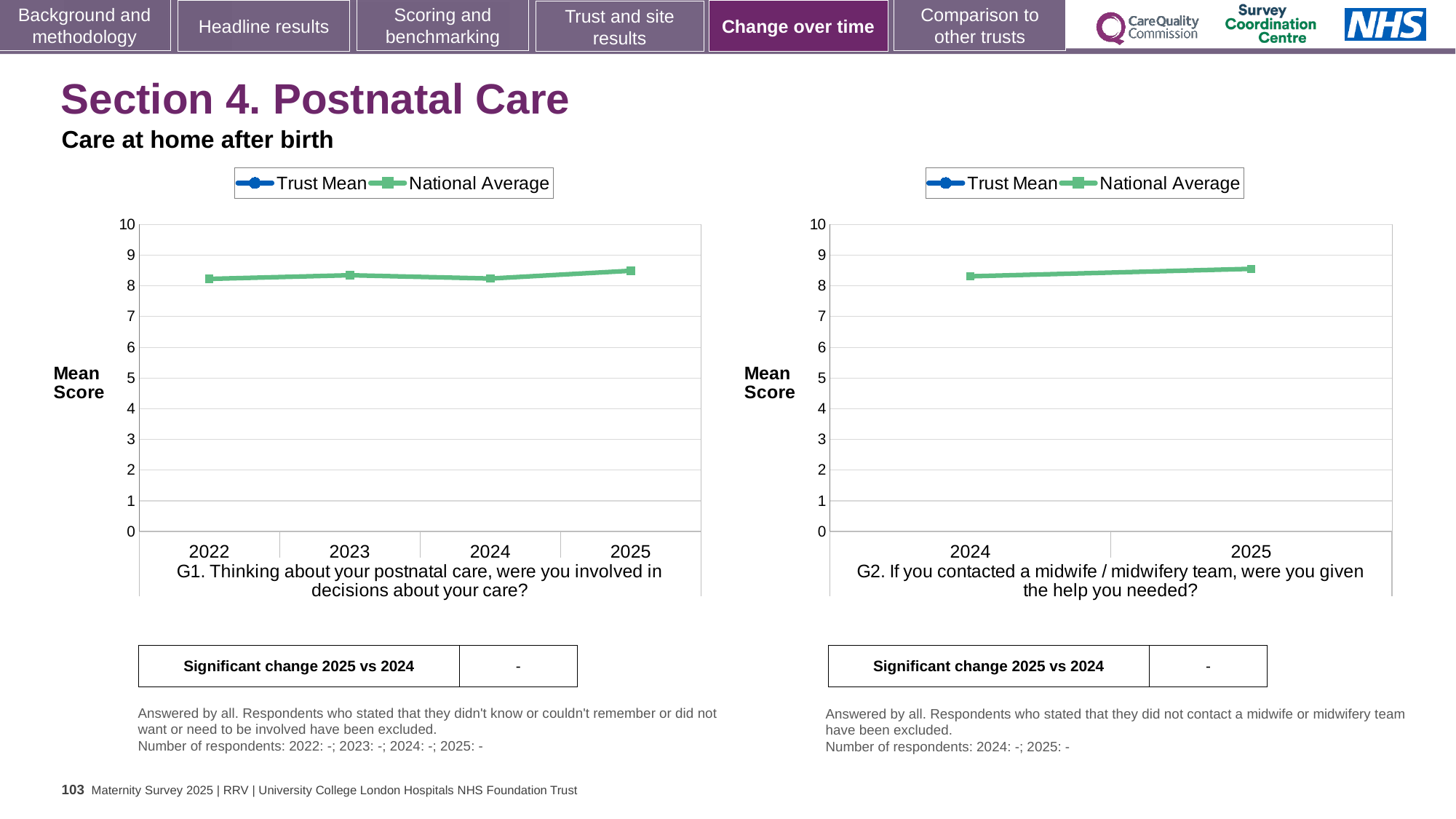
In the left chart (G1), is the National Average value for 2022 greater or less than 9? less What is the y-axis label on the left chart (G1)? Mean Score In the right chart (G2), which year has the higher National Average value, 2024 or 2025? 2025 What are the two legend entries on the right chart (G2)? Trust Mean, National Average How many series does the legend of the left chart (G1) list? 2 What kind of chart is the left chart (G1)? line chart In the left chart (G1), is the National Average value for 2025 greater or less than 8? greater How many years are shown on the x axis of the left chart (G1)? 4 How many years are shown on the x axis of the right chart (G2)? 2 In the left chart (G1), which year has the highest National Average value? 2025 In the right chart (G2), does the National Average rise or fall from 2024 to 2025? rise In the right chart (G2), is the National Average value for 2024 greater or less than 8? greater